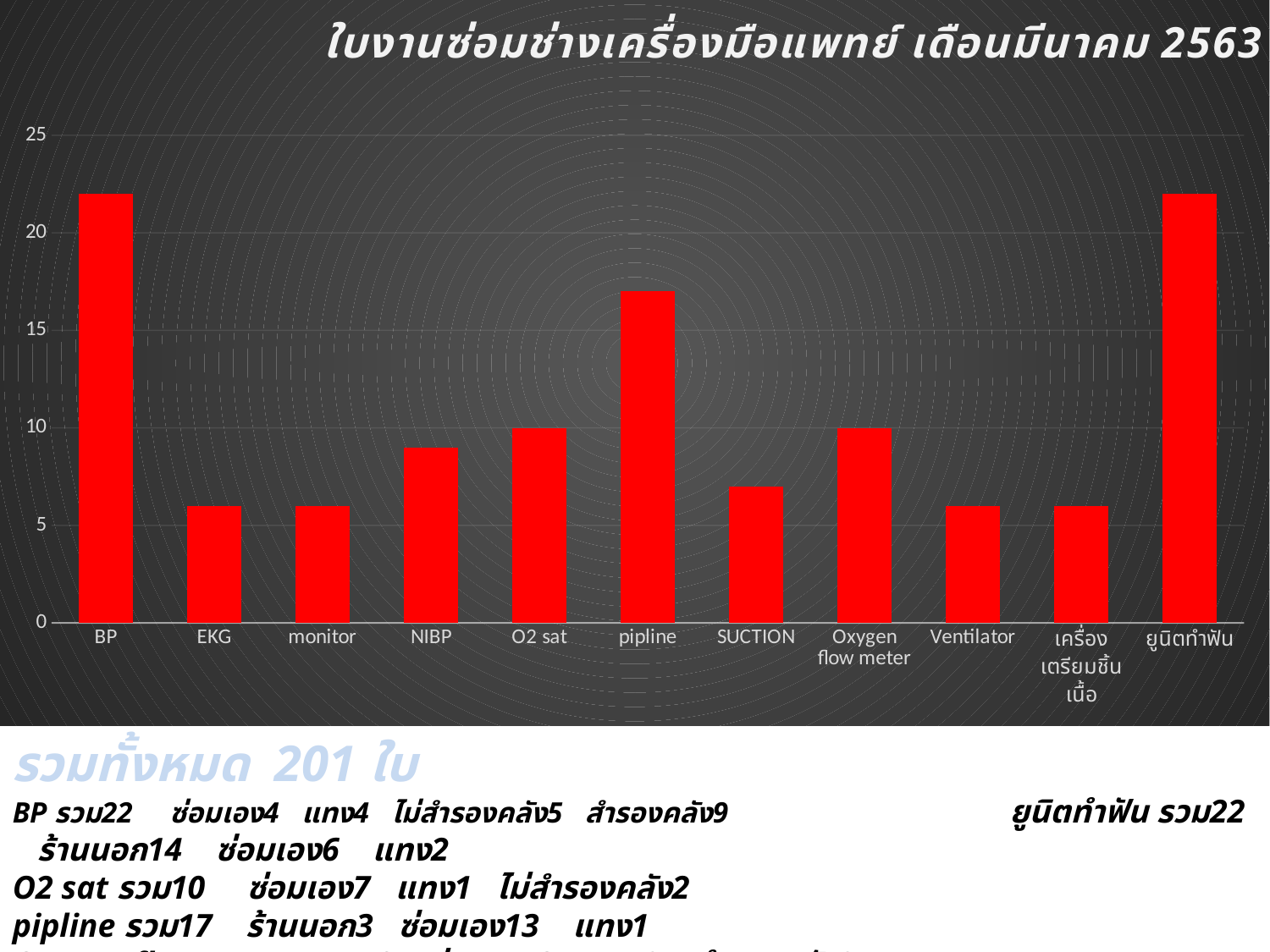
What is the value for pipline? 17 What is the title of the chart? ใบงานซ่อมช่างเครื่องมือแพทย์ เดือนมีนาคม 2563 Which is larger, the value for pipline or the value for SUCTION? pipline Is the value for NIBP greater or less than 10? less Is the value for pipline greater or less than 15? greater Is the value for BP greater or less than 20? greater How many categories are shown on the x axis of the chart? 11 What colour are the bars in the chart? red What type of chart is shown on the slide? bar chart What is the value for Oxygen flow meter? 10 What is the value for O2 sat? 10